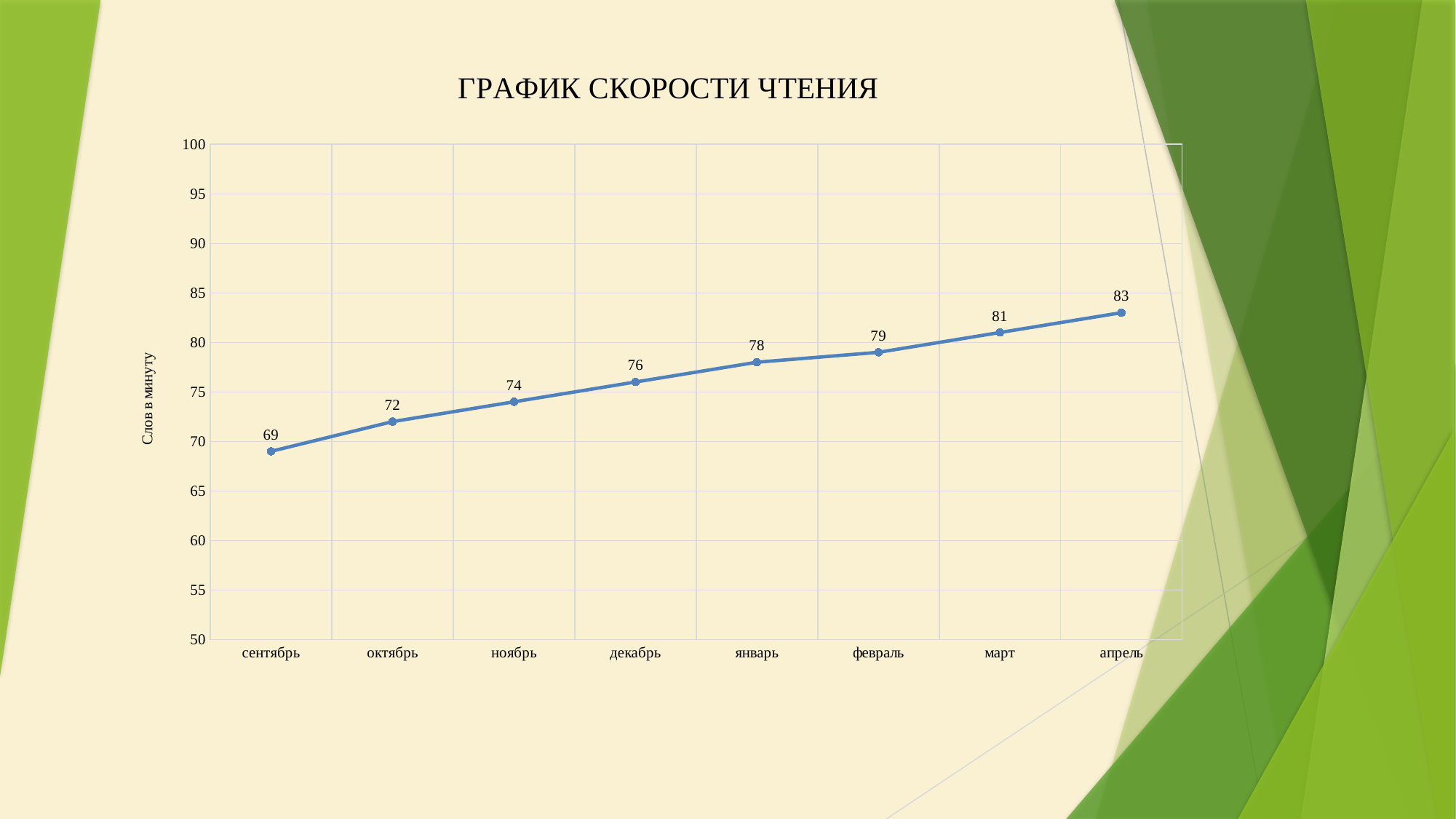
Is the value for ноябрь greater or less than 80? less What is the difference between the values for декабрь and октябрь? 4 What kind of chart is shown on the slide? line chart Which month has the lowest value on the chart? сентябрь Which month has the highest value on the chart? апрель What is the value plotted for январь? 78 Which is larger, the value for март or the value for февраль? март What is the difference between the values for апрель and сентябрь? 14 Do the values rise or fall from сентябрь to апрель? rise What is the reading speed value for сентябрь? 69 What is the value plotted for апрель? 83 How many months are plotted on the x axis? 8